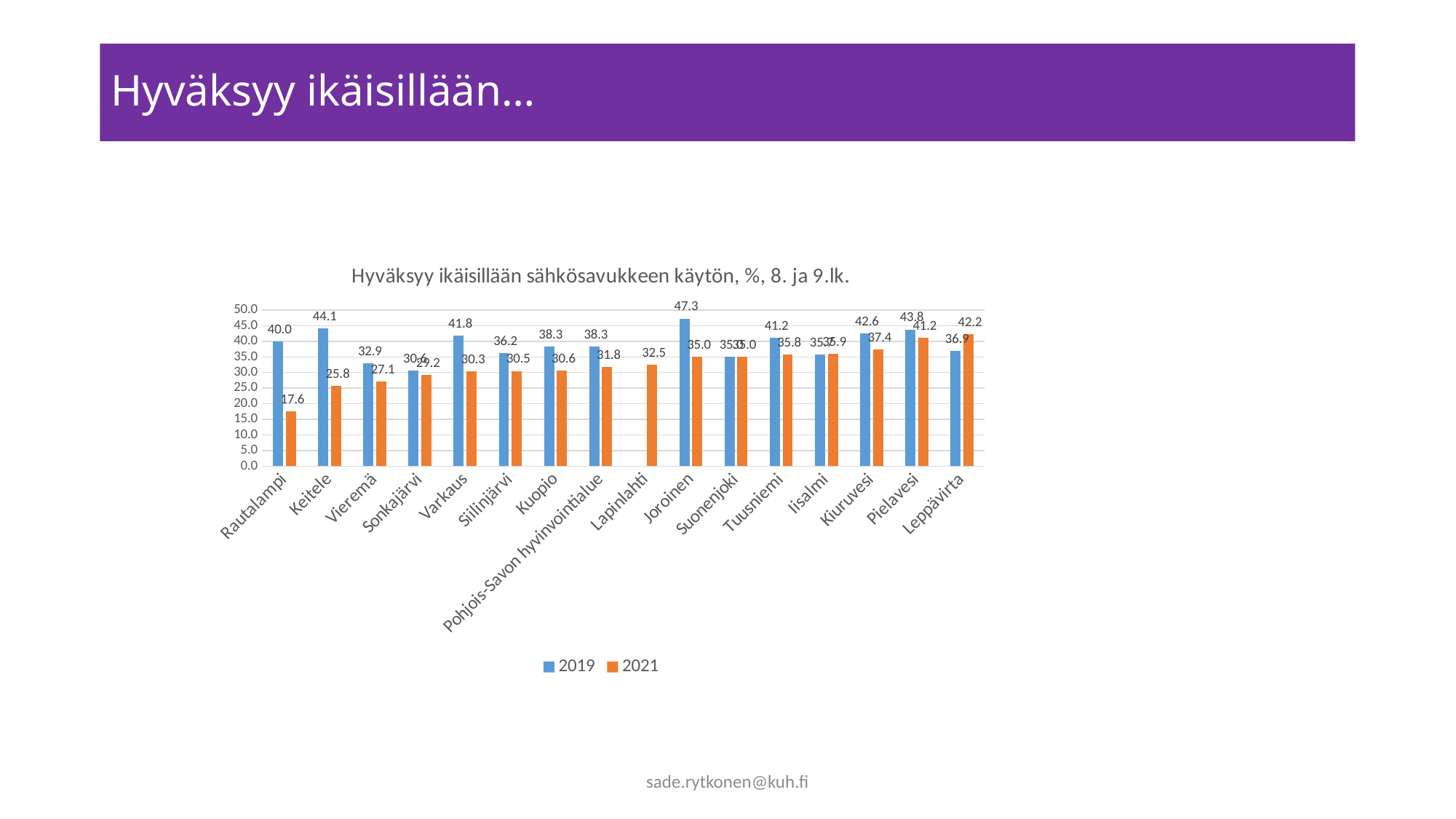
Which is larger for Leppävirta, the 2019 value or the 2021 value? 2021 What is the 2021 value for Lapinlahti? 32.5 Is the 2019 value for Joroinen greater or less than 45.0? greater What is the difference between the 2019 and 2021 values for Rautalampi? 22.4 Which category has the lowest 2021 value? Rautalampi What is the title of the chart? Hyväksyy ikäisillään sähkösavukkeen käytön, %, 8. ja 9.lk. How many series does the legend list? 2 Which category has the highest 2019 value? Joroinen What is the 2021 value for Rautalampi? 17.6 What type of chart is shown on the slide? bar chart What is the 2019 value for Keitele? 44.1 How many categories are shown on the x axis? 16